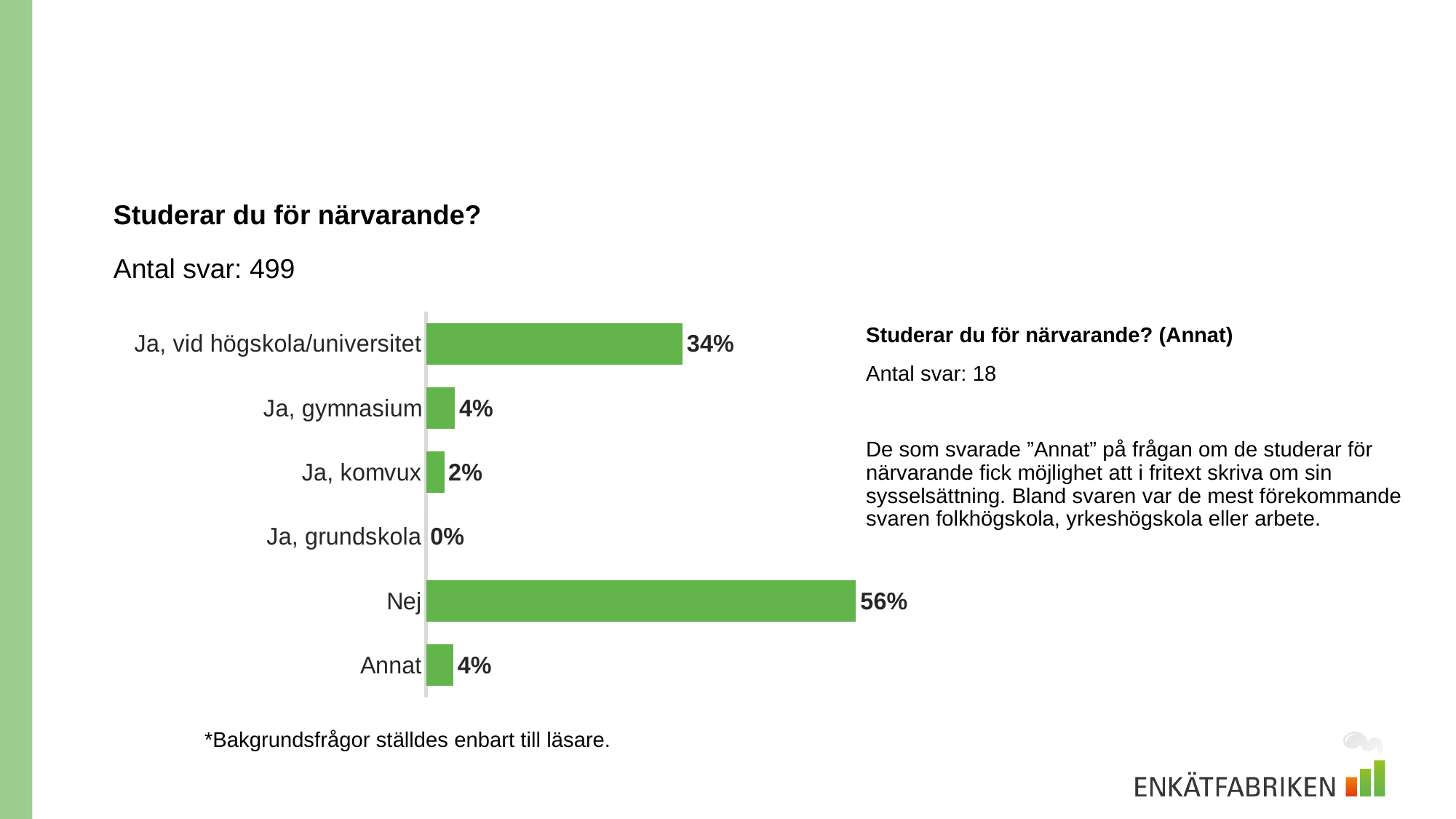
What is the value for "Ja, vid högskola/universitet"? 34% How many categories are shown in the chart? 6 What is the value for "Ja, grundskola"? 0% What is the title of the chart? Studerar du för närvarande? What is the value for "Ja, komvux"? 2% Which is larger, the value for "Ja, gymnasium" or the value for "Ja, komvux"? Ja, gymnasium What is the value for "Nej"? 56% What kind of chart is shown on the slide? Bar chart Which category has the lowest value? Ja, grundskola Which category has the highest value? Nej How many responses (Antal svar) does the chart report? 499 What is the difference between the values for "Nej" and "Ja, vid högskola/universitet"? 22%